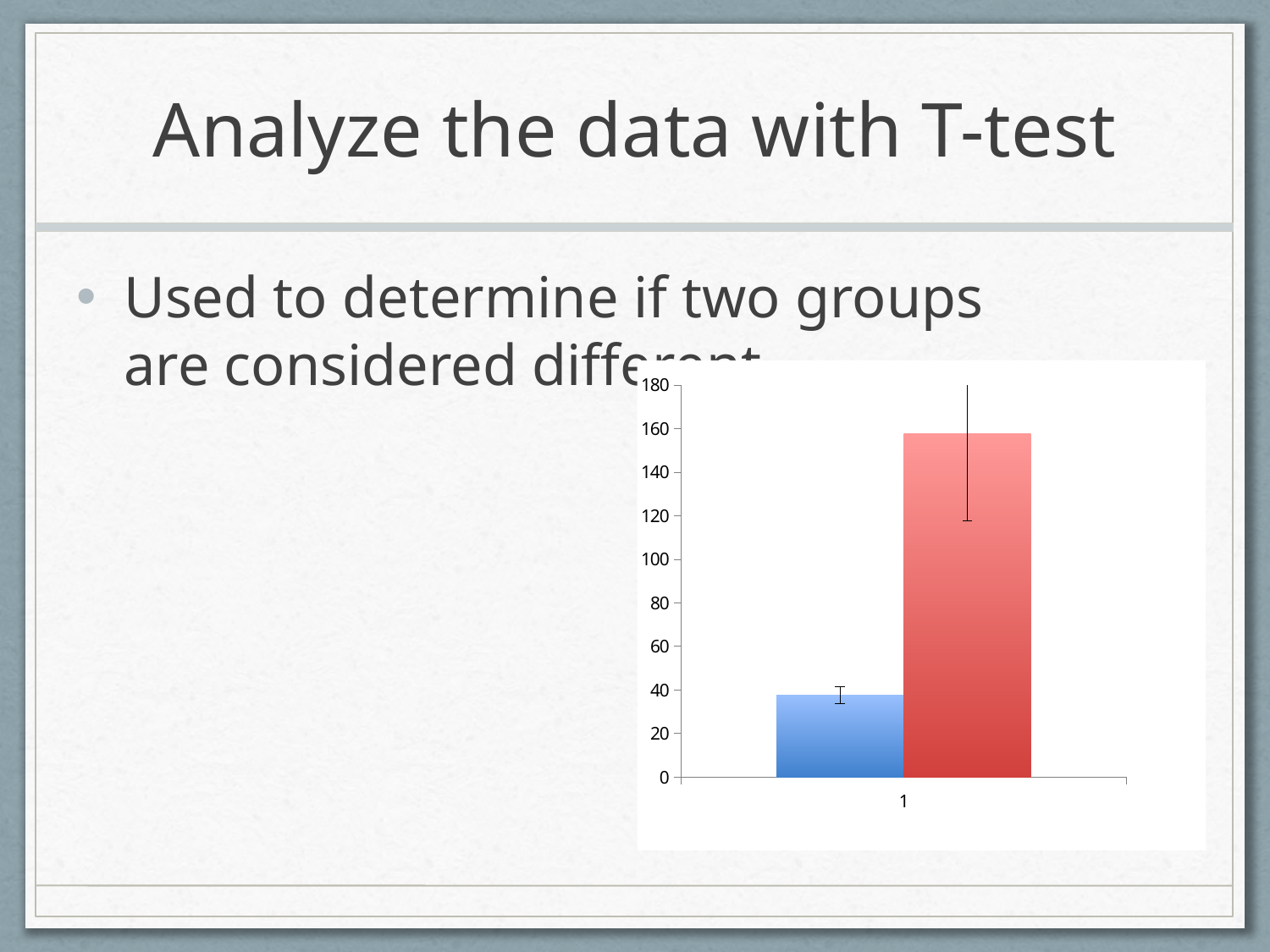
Is the value of the red bar greater or less than 180? less What is the highest value shown on the vertical axis of the chart? 180 How many bars are plotted in the chart? 2 Which bar has the highest value in the chart? the red bar Is the value of the red bar greater or less than 140? greater Is the value of the blue bar greater or less than 20? greater What kind of chart is shown on the slide? bar chart How many categories are shown on the x axis of the chart? 1 What is the label of the single category on the x axis? 1 Which bar is taller, the blue bar or the red bar? the red bar Which bar has the lowest value in the chart? the blue bar